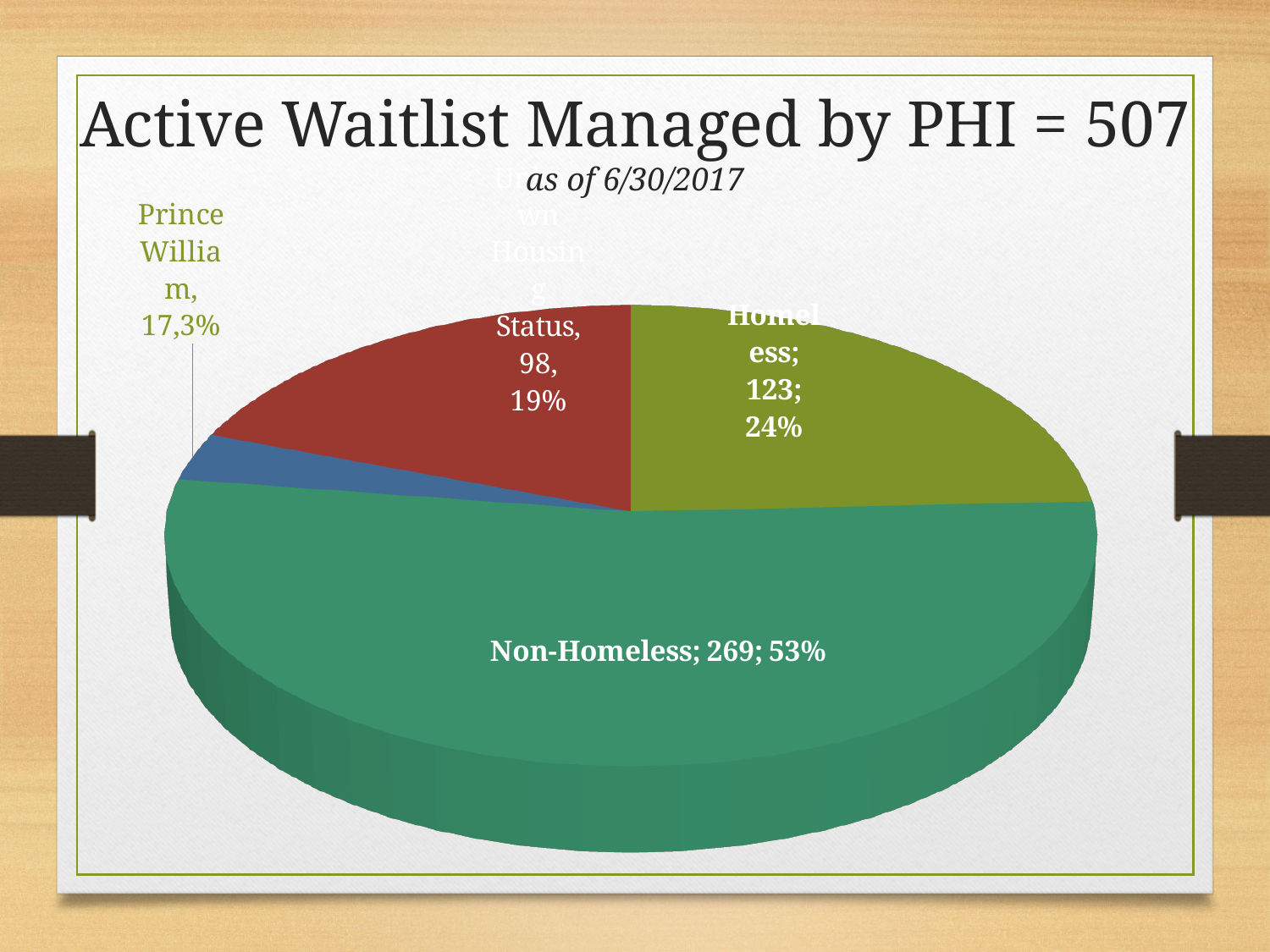
How many people are in the Prince William slice of the pie chart? 17 What share of the pie does the Homeless slice represent? 24% What share of the pie does the Prince William slice represent? 3% Which slice of the pie chart is the smallest? Prince William According to the slide title, what is the total active waitlist managed by PHI? 507 How many more people are in the Non-Homeless slice than in the Homeless slice? 146 How many people are in the Homeless slice of the pie chart? 123 How many people are in the Non-Homeless slice of the pie chart? 269 How many slices does the pie chart have? 4 What kind of chart is shown on the slide? pie chart What share of the pie does the Non-Homeless slice represent? 53% Which slice of the pie chart is the largest? Non-Homeless